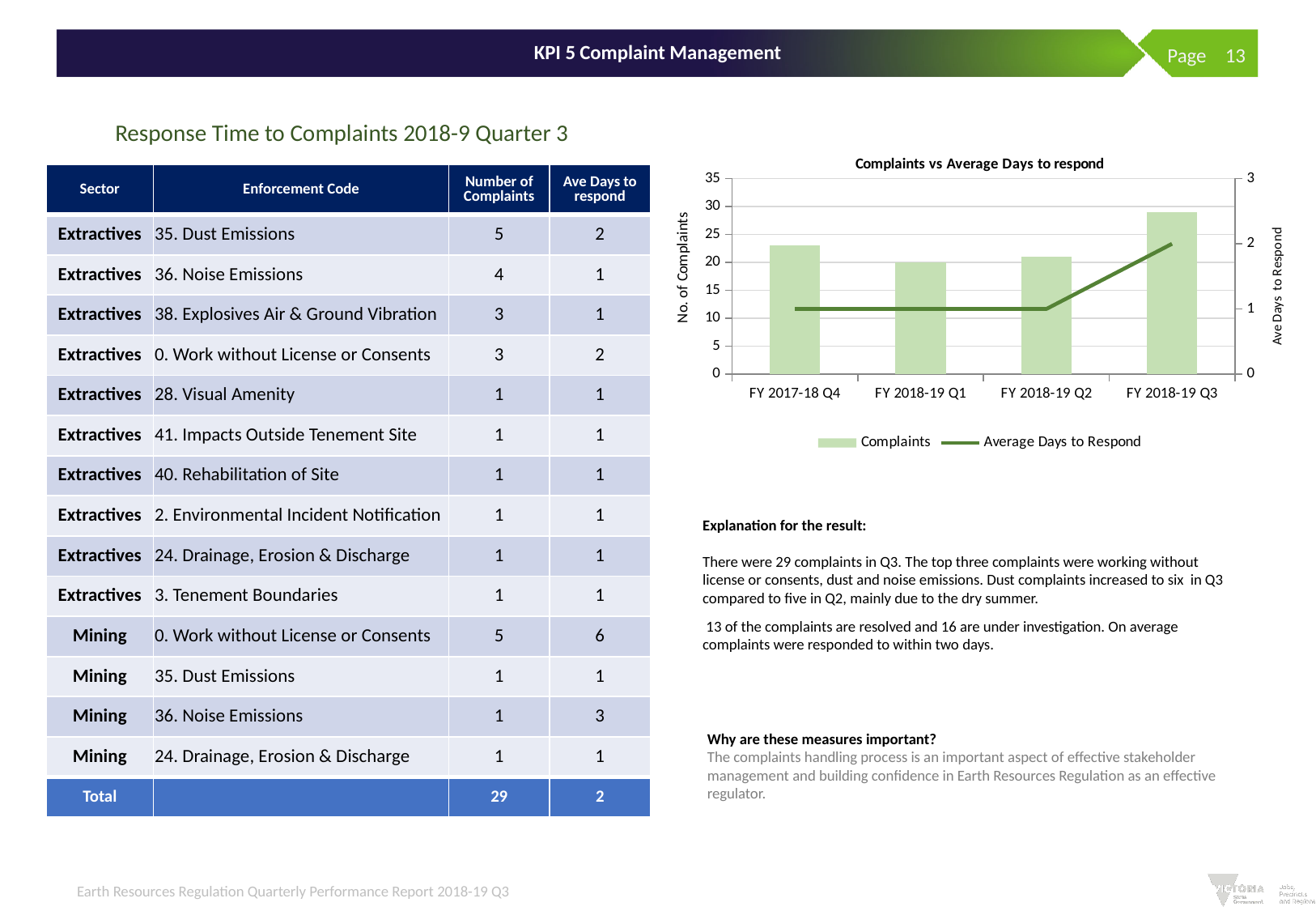
Is the number of complaints for FY 2018-19 Q3 greater or less than 25? greater How many quarters are plotted along the x axis of the chart? 4 Is the number of complaints for FY 2018-19 Q2 greater or less than 25? less What are the two series named in the chart legend? Complaints and Average Days to Respond How many series does the chart legend list? 2 Does the Average Days to Respond line rise or fall between FY 2018-19 Q2 and FY 2018-19 Q3? rise Which has more complaints in the chart, FY 2018-19 Q3 or FY 2018-19 Q2? FY 2018-19 Q3 Is the number of complaints for FY 2017-18 Q4 greater or less than 20? greater What kind of chart is shown on the slide? Combined bar and line chart What is the title of the chart on the slide? Complaints vs Average Days to respond Which quarter has the highest number of complaints in the chart? FY 2018-19 Q3 Which has more complaints in the chart, FY 2017-18 Q4 or FY 2018-19 Q1? FY 2017-18 Q4